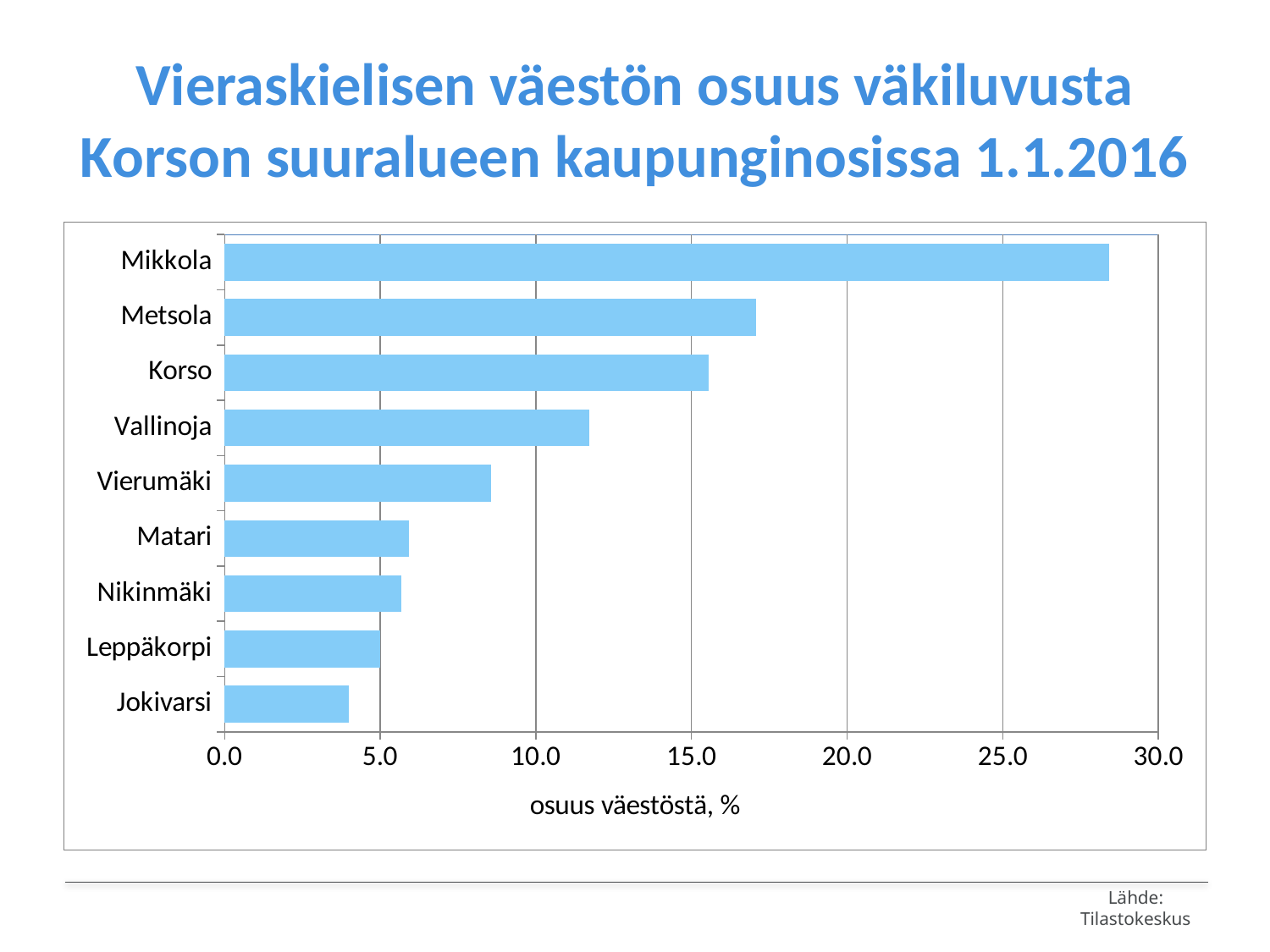
Is the value for Metsola greater or less than 15.0? greater What is the label of the horizontal axis? osuus väestöstä, % Which has a larger value, Vallinoja or Vierumäki? Vallinoja Is the value for Mikkola greater or less than 25.0? greater Which district has the lowest share of foreign-language population? Jokivarsi Which district has the highest share of foreign-language population? Mikkola Which has a larger value, Metsola or Korso? Metsola Is the value for Jokivarsi greater or less than 5.0? less What kind of chart is shown on the slide? bar chart How many city districts are shown in the chart? 9